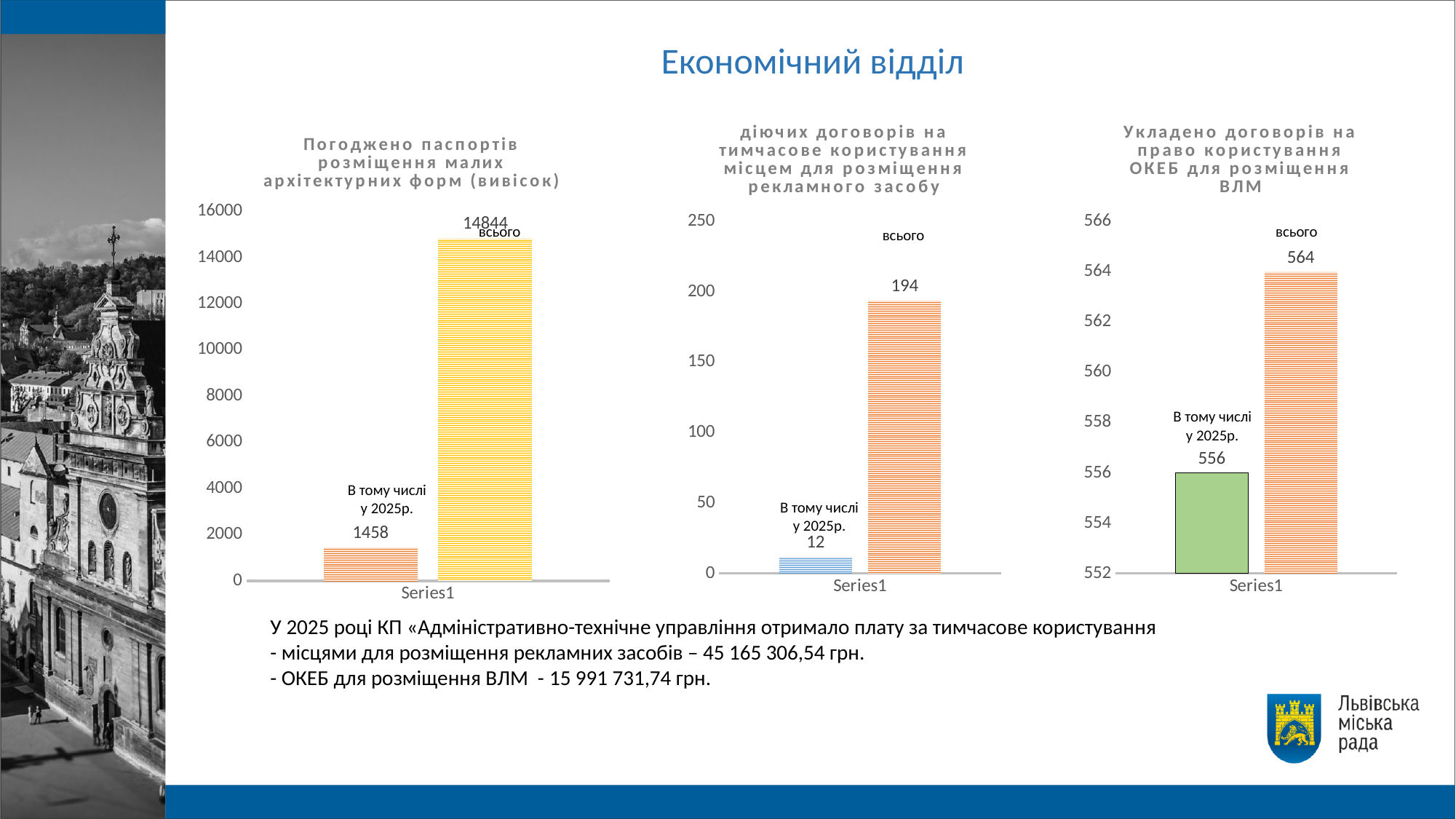
In the middle chart (діючих договорів на тимчасове користування місцем), what is the value labelled 'всього'? 194 How many bars are plotted in the left chart (Погоджено паспортів розміщення малих архітектурних форм)? 2 In the middle chart, what is the difference between the 'всього' value and the 'В тому числі у 2025р.' value? 182 In the right chart, what is the difference between the 'всього' value and the 'В тому числі у 2025р.' value? 8 In the right chart (Укладено договорів на право користування ОКЕБ), what is the value for 'В тому числі у 2025р.'? 556 In the middle chart, which bar is taller: 'всього' or 'В тому числі у 2025р.'? всього In the right chart (Укладено договорів на право користування ОКЕБ), what is the value labelled 'всього'? 564 In the middle chart (діючих договорів на тимчасове користування місцем), what is the value for 'В тому числі у 2025р.'? 12 In the left chart (Погоджено паспортів розміщення малих архітектурних форм), what is the value for 'В тому числі у 2025р.'? 1458 In the left chart, what is the difference between the 'всього' value and the 'В тому числі у 2025р.' value? 13386 In the left chart (Погоджено паспортів розміщення малих архітектурних форм), what is the value labelled 'всього'? 14844 What type of chart is the right chart (Укладено договорів на право користування ОКЕБ)? bar chart